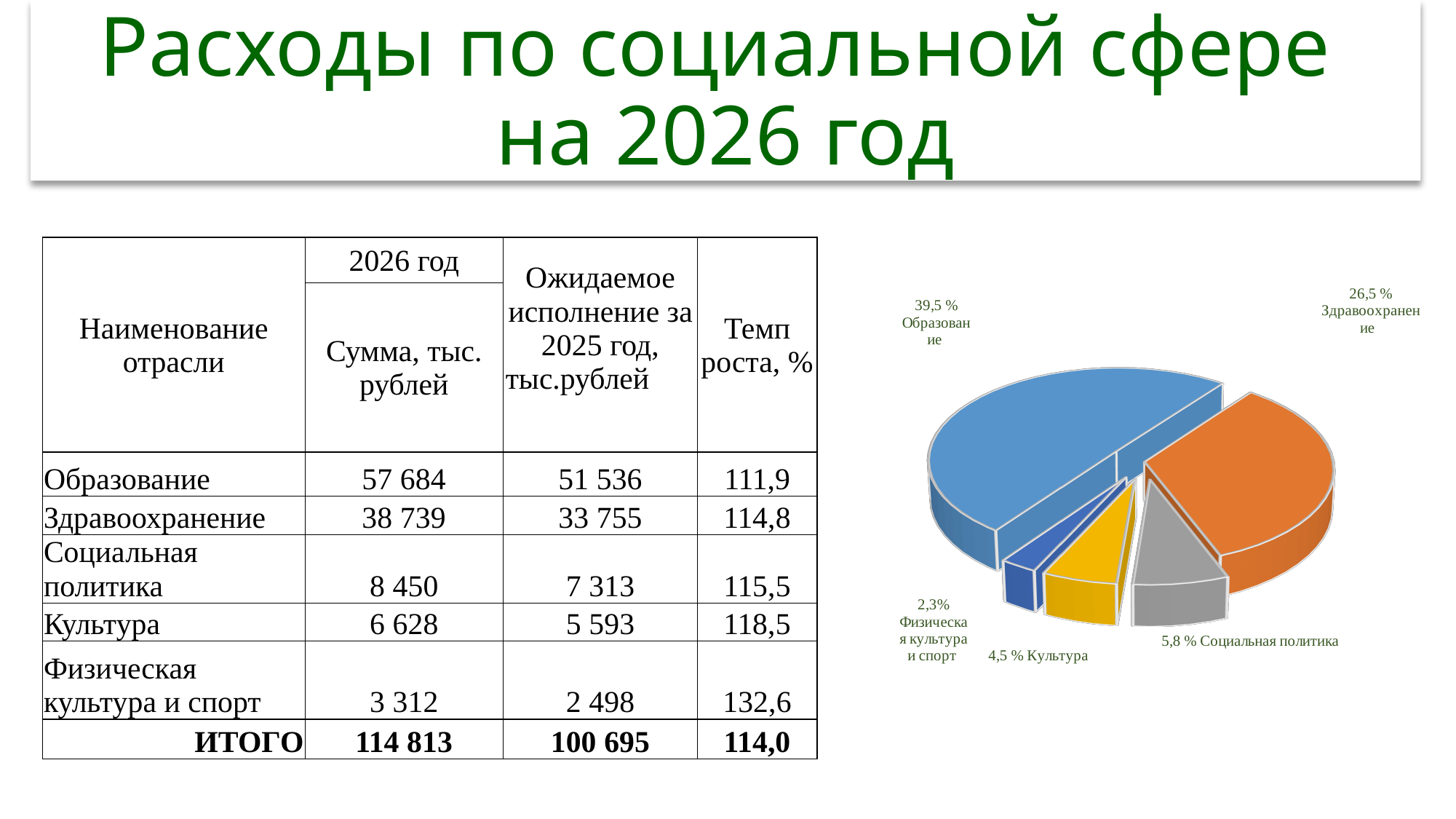
In the pie chart, which is larger: the share for Здравоохранение or the share for Социальная политика? Здравоохранение In the pie chart, what is the difference between the labelled shares for Образование and Здравоохранение? 13 percentage points How many slices does the pie chart have? 5 In the pie chart, what share is labelled for Физическая культура и спорт? 2,3% Which slice of the pie chart is the smallest? Физическая культура и спорт In the pie chart, what share is labelled for Здравоохранение? 26,5 % Which slice of the pie chart is the largest? Образование In the pie chart, what share is labelled for Культура? 4,5 % In the pie chart, what share is labelled for Образование? 39,5 % What colour is the Образование slice in the pie chart? Blue In the pie chart, what share is labelled for Социальная политика? 5,8 % What kind of chart is shown on the right of the slide? Pie chart